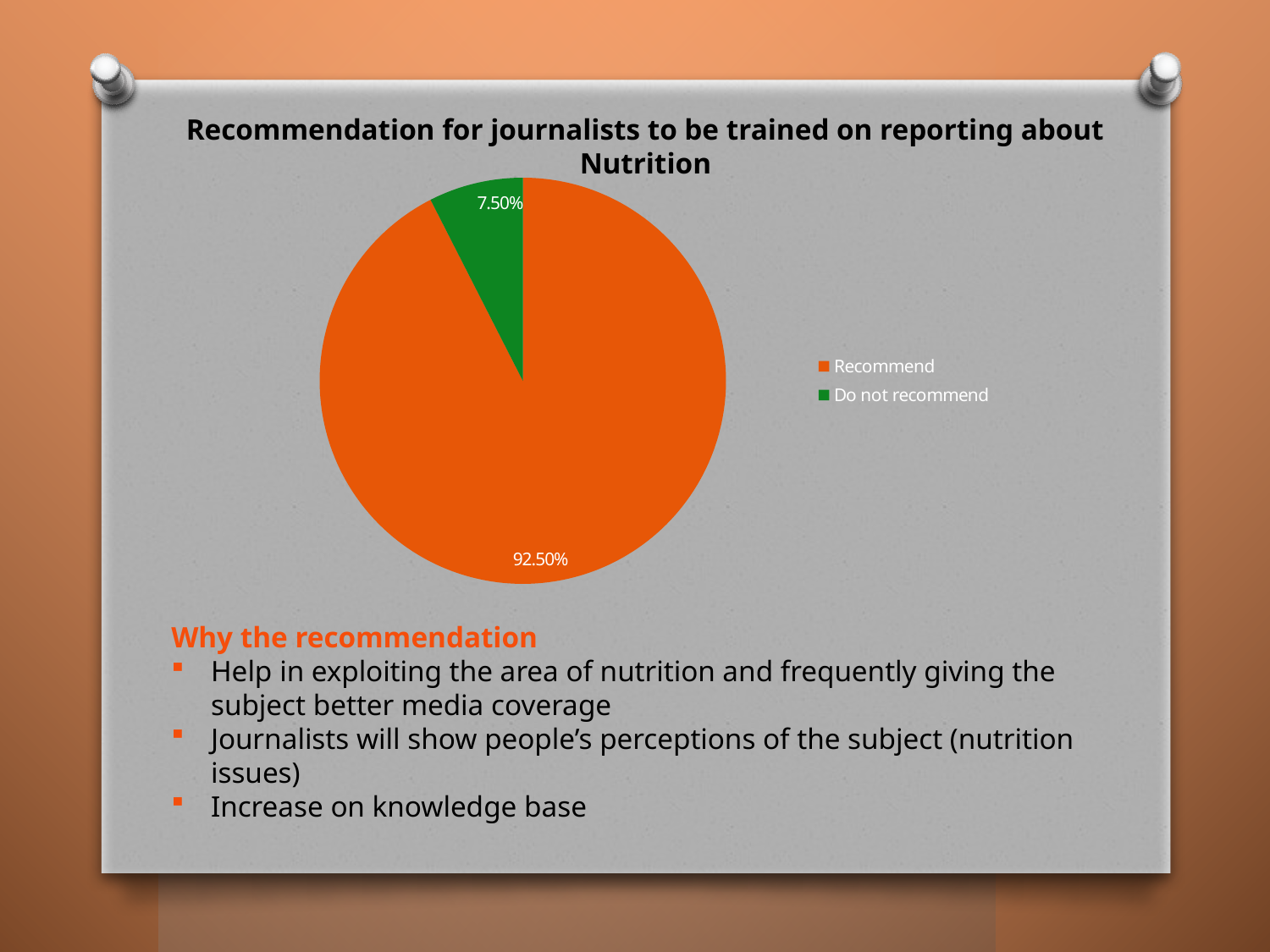
What is the difference between the Recommend and Do not recommend shares? 85.00% What share of the pie does the Recommend slice represent? 92.50% Which category has the largest share of the pie? Recommend What colour is the Do not recommend slice? green How many entries does the legend list? 2 How many categories does the pie chart have? 2 Which is larger, the share for Recommend or the share for Do not recommend? Recommend Which category has the smallest share of the pie? Do not recommend What is the value for Recommend? 92.50% What is the value for Do not recommend? 7.50% What type of chart is shown on the slide? pie chart What is the title of the chart? Recommendation for journalists to be trained on reporting about Nutrition